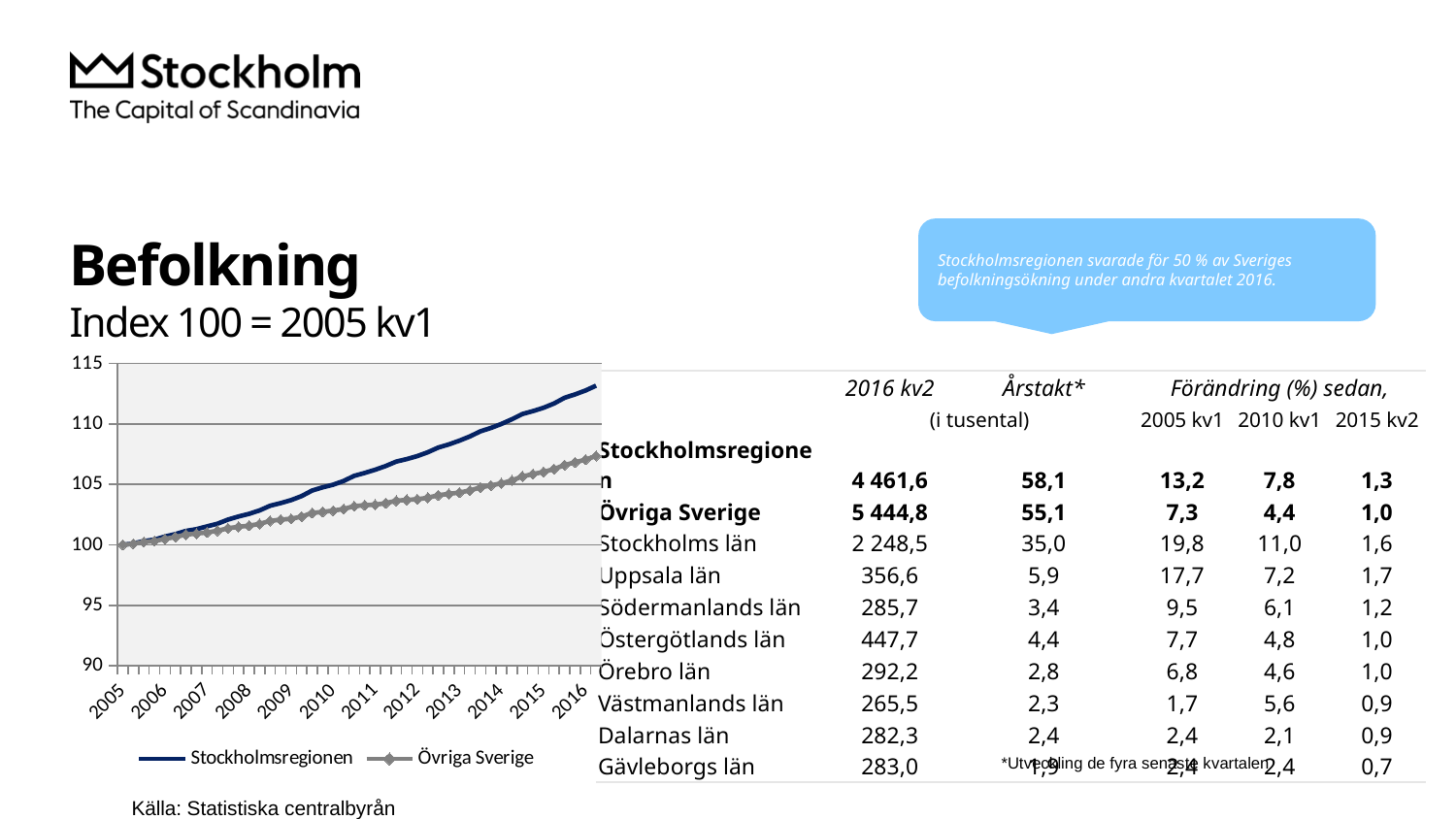
Do the values for Stockholmsregionen rise or fall from 2005 to 2016? rise Is the value for Övriga Sverige in 2016 greater or less than 110? less How many year labels are shown on the x axis of the chart? 12 Which series is higher at the end of the chart in 2016, Stockholmsregionen or Övriga Sverige? Stockholmsregionen What are the two series named in the chart legend? Stockholmsregionen and Övriga Sverige How many series does the chart legend list? 2 What type of chart is shown on the slide? line chart Is the value for Stockholmsregionen in 2013 greater or less than 105? greater What is the index base stated in the chart subtitle? Index 100 = 2005 kv1 Is the value for Övriga Sverige in 2010 greater or less than 105? less Do the values for Övriga Sverige rise or fall from 2005 to 2016? rise